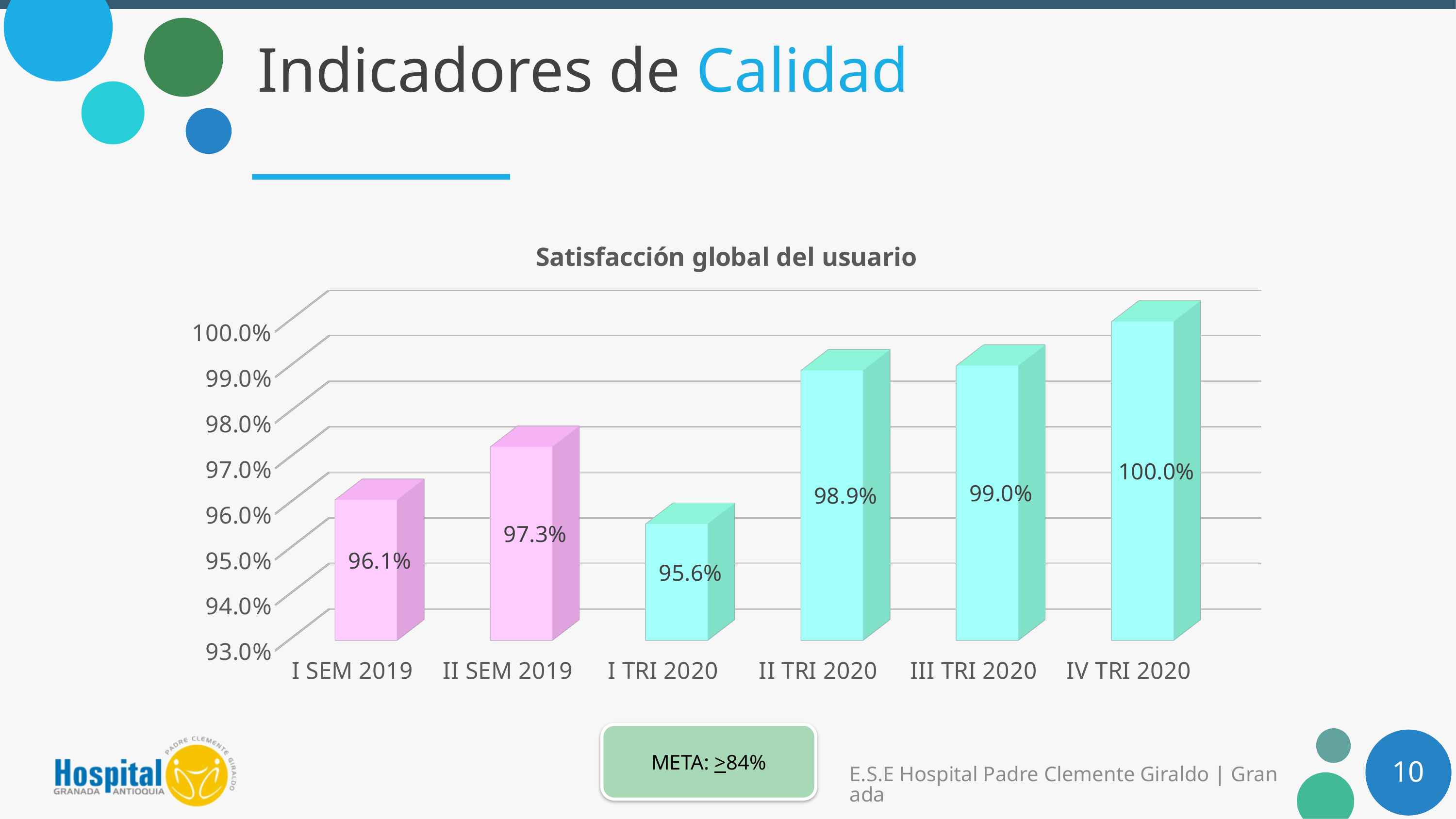
What is the value for I SEM 2019? 96.1% What is the value for I TRI 2020? 95.6% Which is larger, the value for II SEM 2019 or the value for I TRI 2020? II SEM 2019 What is the value for II TRI 2020? 98.9% How many periods are shown on the x axis? 6 What kind of chart is shown? Bar chart What is the value for II SEM 2019? 97.3% What is the title of the chart? Satisfacción global del usuario Which period has the highest value? IV TRI 2020 What is the value for IV TRI 2020? 100.0% What is the difference between the values for IV TRI 2020 and I TRI 2020? 4.4% Which period has the lowest value? I TRI 2020